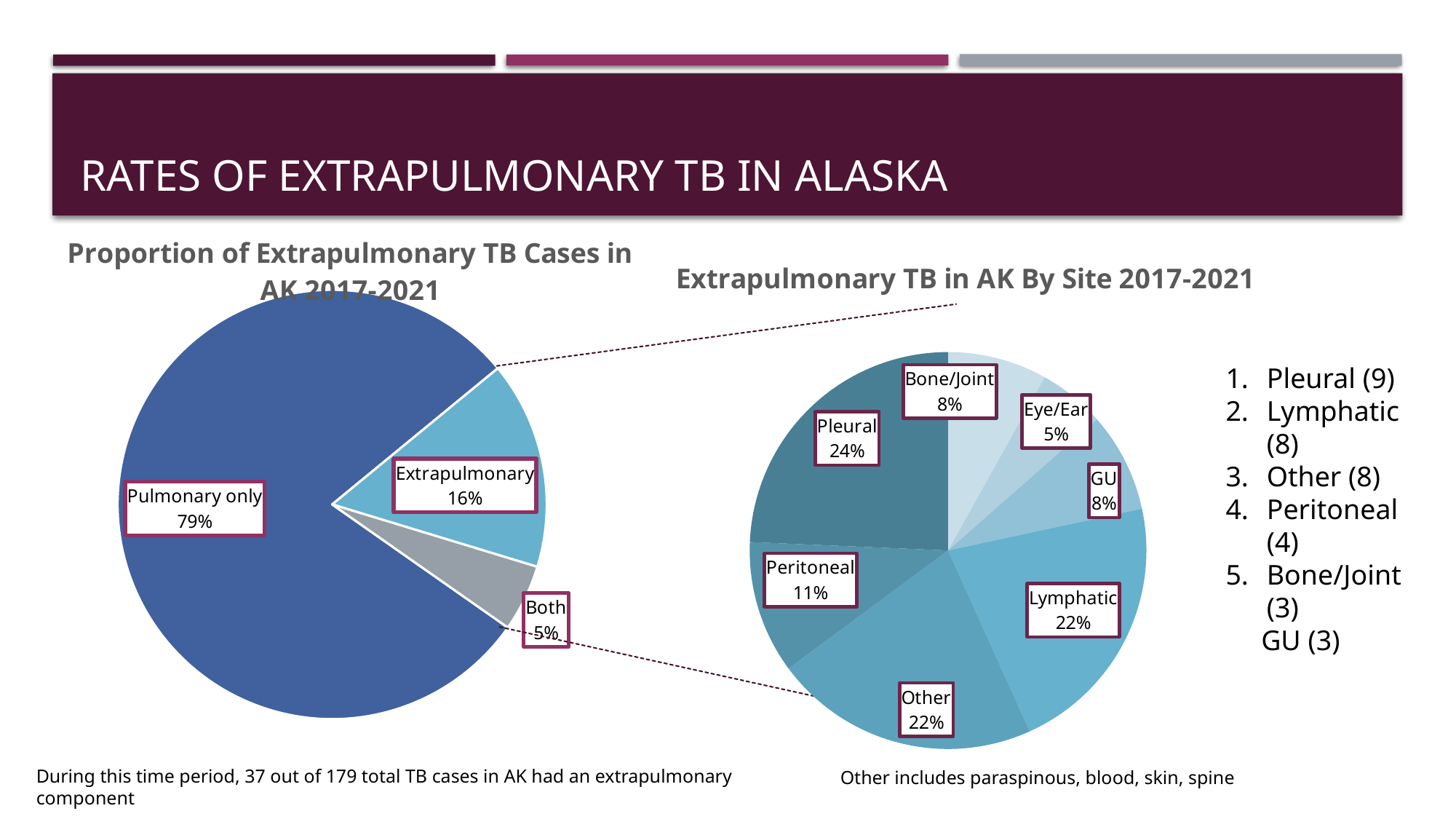
In the 'Extrapulmonary TB in AK By Site 2017-2021' chart, which site has the largest share? Pleural What kind of chart is 'Extrapulmonary TB in AK By Site 2017-2021'? Pie chart In the 'Extrapulmonary TB in AK By Site 2017-2021' chart, what percentage is labelled for Peritoneal? 11% In the 'Proportion of Extrapulmonary TB Cases in AK 2017-2021' chart, what percentage is labelled for Extrapulmonary? 16% In the 'Extrapulmonary TB in AK By Site 2017-2021' chart, how many site categories are shown? 7 In the 'Proportion of Extrapulmonary TB Cases in AK 2017-2021' chart, how many slices does the pie have? 3 In the 'Extrapulmonary TB in AK By Site 2017-2021' chart, what percentage is labelled for Pleural? 24% In the 'Extrapulmonary TB in AK By Site 2017-2021' chart, what is the difference in percentage points between Pleural and Peritoneal? 13 percentage points In the 'Extrapulmonary TB in AK By Site 2017-2021' chart, which is larger, Lymphatic or Bone/Joint? Lymphatic In the 'Proportion of Extrapulmonary TB Cases in AK 2017-2021' chart, what percentage is labelled for Pulmonary only? 79% In the 'Proportion of Extrapulmonary TB Cases in AK 2017-2021' chart, which slice is the smallest? Both In the 'Extrapulmonary TB in AK By Site 2017-2021' chart, which site has the smallest share? Eye/Ear